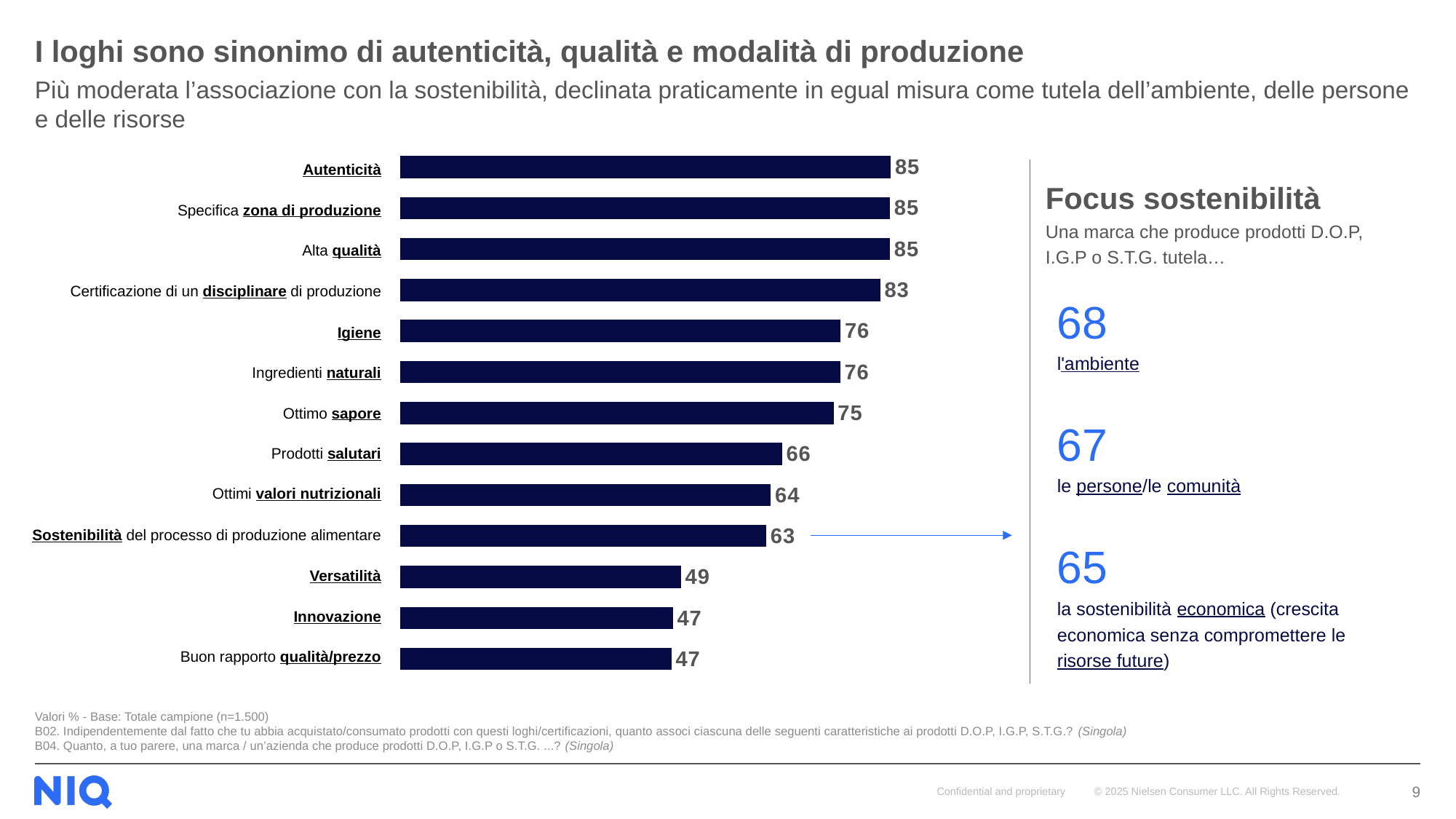
What kind of chart is shown on the slide? Bar chart What value is shown for Versatilità in the bar chart? 49 What is the highest value shown in the bar chart? 85 What is the difference between the values for Prodotti salutari and Ottimi valori nutrizionali? 2 What value is shown for Igiene in the bar chart? 76 What is the lowest value shown in the bar chart? 47 Do the values in the bar chart increase or decrease from top to bottom? Decrease What value is shown for Certificazione di un disciplinare di produzione? 83 What is the difference between the values for Autenticità and Innovazione? 38 How many categories are shown in the bar chart? 13 Which has a larger value, Ottimo sapore or Versatilità? Ottimo sapore What value is shown for Sostenibilità del processo di produzione alimentare? 63